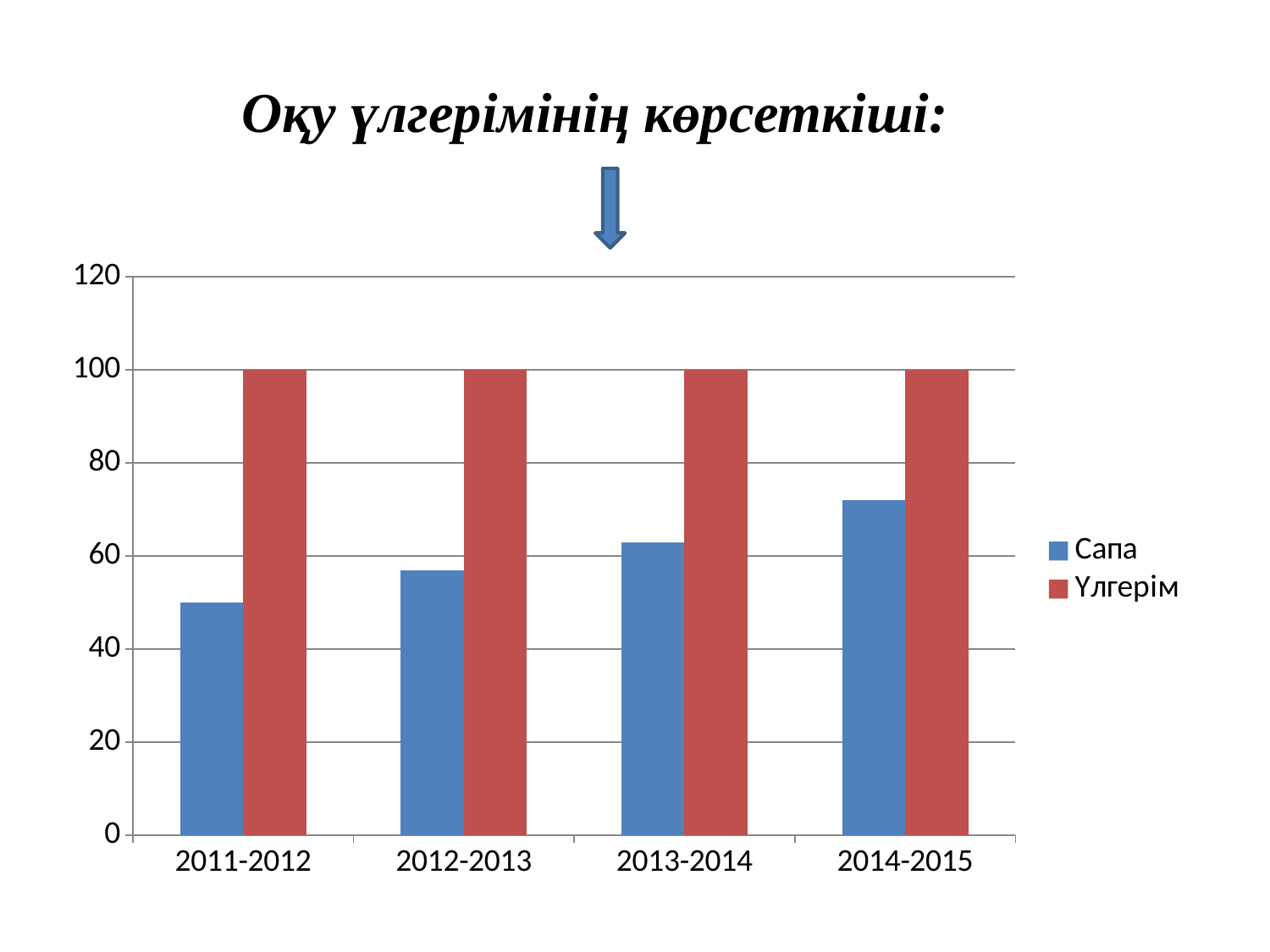
How many academic years are shown on the x axis? 4 Do the Сапа values rise or fall from 2011-2012 to 2014-2015? rise What type of chart is shown on the slide? bar chart Which series is shown in red? Үлгерім How many series does the legend list? 2 Is the value for Сапа in 2013-2014 greater or less than 80? less Is the value for Сапа in 2011-2012 greater or less than 60? less What is the value of Үлгерім for 2011-2012? 100 Is the value for Сапа in 2014-2015 greater or less than 60? greater Which year has the highest value for Сапа? 2014-2015 Which year has the lowest value for Сапа? 2011-2012 What is the value of Үлгерім for 2013-2014? 100